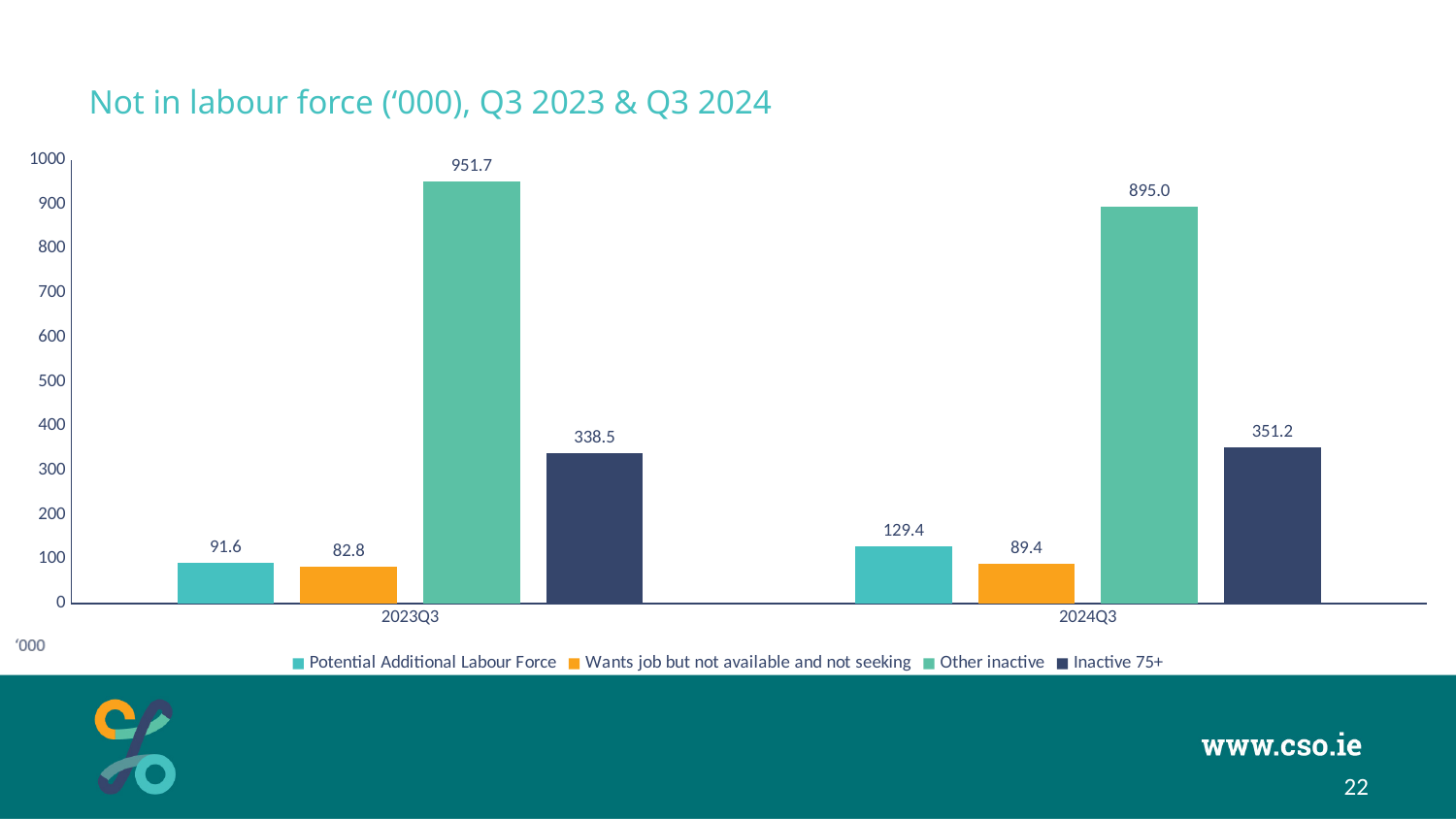
What is the value for Other inactive in 2023Q3? 951.7 Is the Potential Additional Labour Force value larger in 2023Q3 or 2024Q3? 2024Q3 Which series has the highest value in 2024Q3? Other inactive What is the value for Wants job but not available and not seeking in 2023Q3? 82.8 What kind of chart is shown on the slide? Bar chart What is the value for Potential Additional Labour Force in 2024Q3? 129.4 How many series does the legend list? 4 How many quarters are shown on the x axis? 2 What is the title of the chart? Not in labour force ('000), Q3 2023 & Q3 2024 Which series has the lowest value in 2023Q3? Wants job but not available and not seeking What is the value for Inactive 75+ in 2024Q3? 351.2 What is the difference between the Other inactive values for 2023Q3 and 2024Q3? 56.7